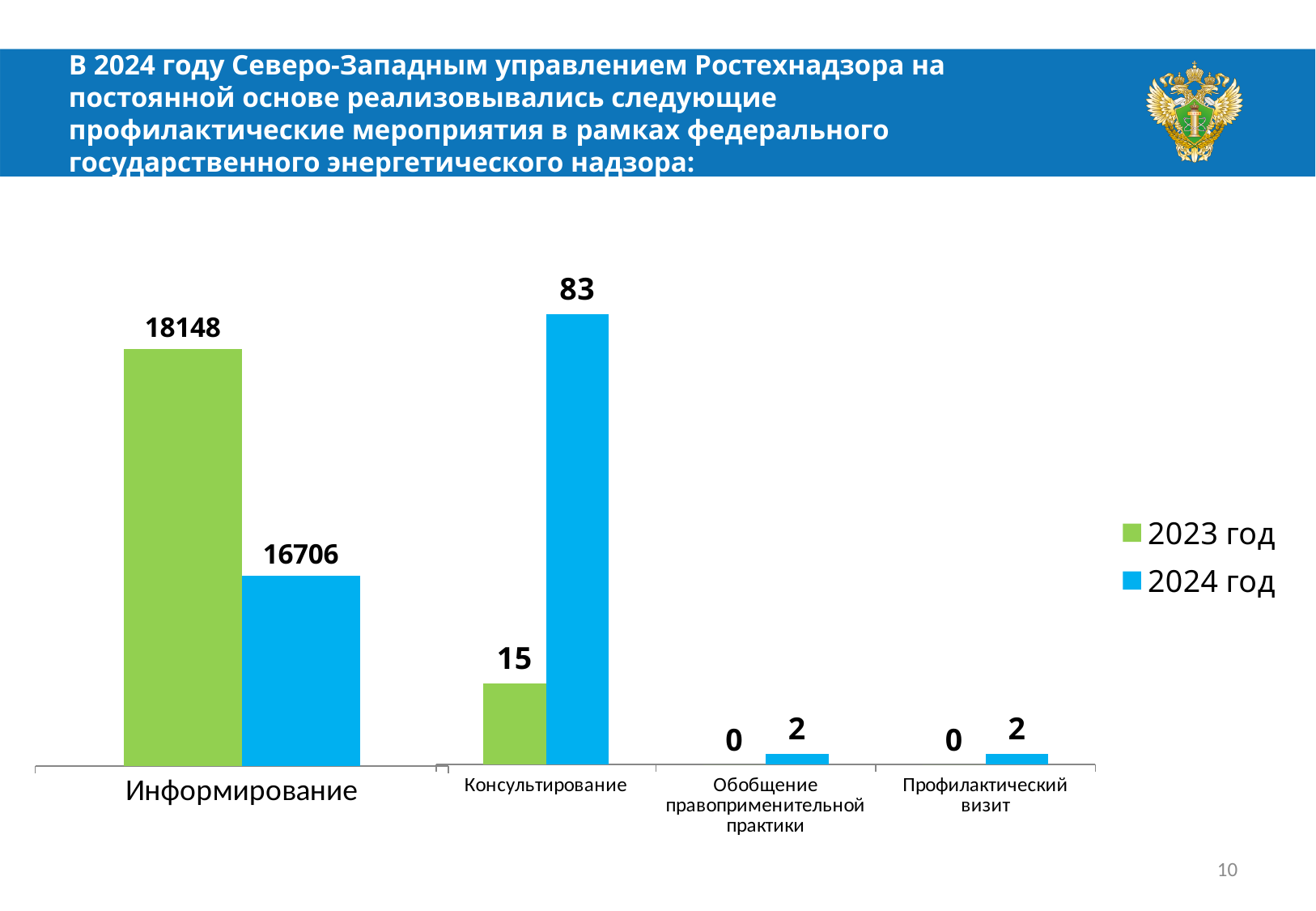
What is the value for Информирование in the 2024 год series? 16706 How many series does the legend list? 2 What is the value for Профилактический визит in the 2023 год series? 0 Which category has the highest value in the 2024 год series? Информирование What is the value for Информирование in the 2023 год series? 18148 Which is larger for Консультирование: the 2023 год value or the 2024 год value? 2024 год What is the value for Консультирование in the 2024 год series? 83 What kind of chart is shown on the slide? Bar chart What is the value for Обобщение правоприменительной практики in the 2024 год series? 2 What is the difference between the 2024 год and 2023 год values for Консультирование? 68 What is the difference between the 2023 год and 2024 год values for Информирование? 1442 What is the value for Консультирование in the 2023 год series? 15